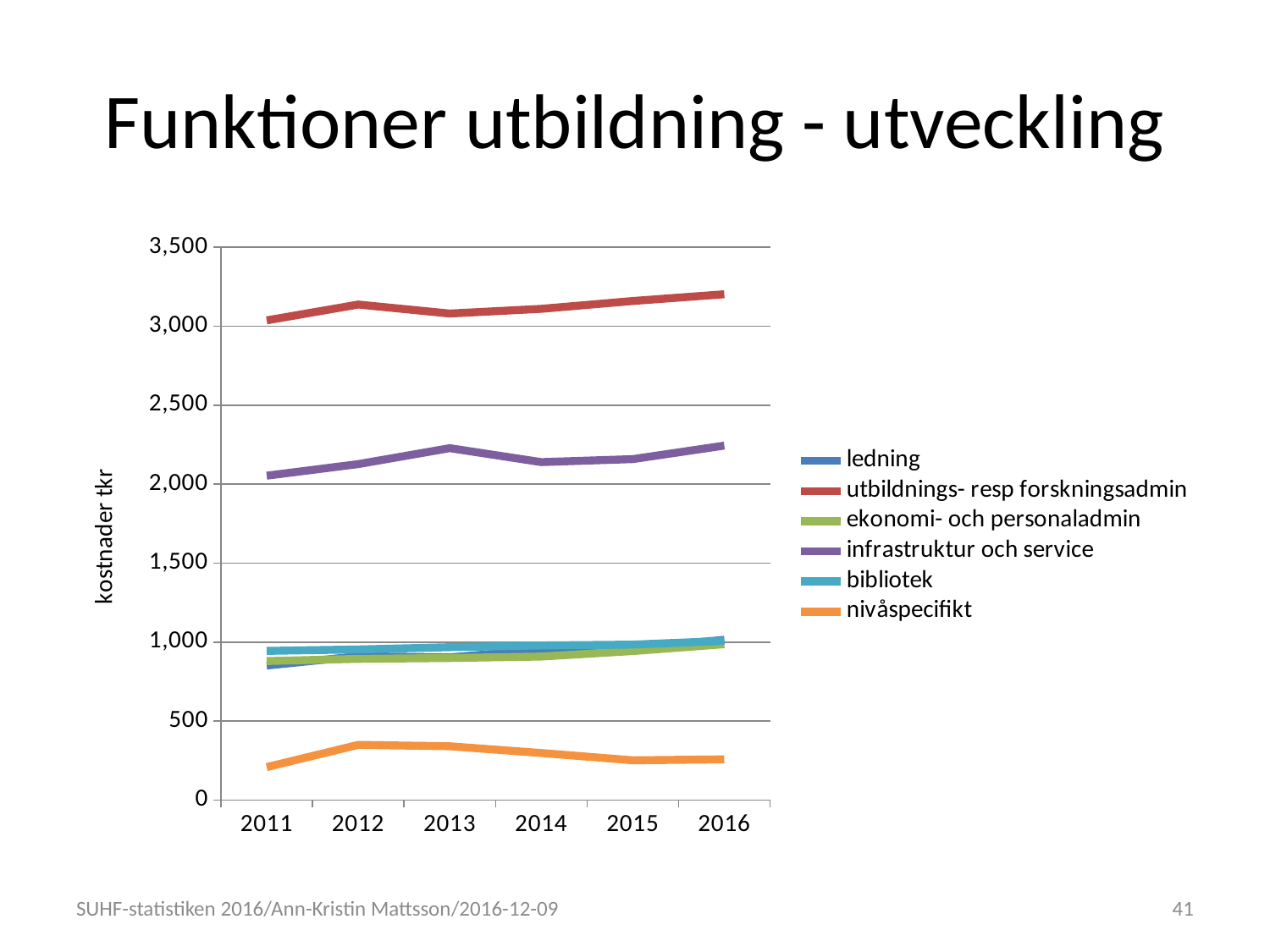
Is the value for infrastruktur och service in 2013 greater or less than 2,000? greater Does the nivåspecifikt series rise or fall from 2012 to 2015? fall Which series has the lowest values across all years? nivåspecifikt Is the value for nivåspecifikt in 2012 greater or less than 500? less What kind of chart is shown on the slide? line chart In 2016, which is larger: infrastruktur och service or bibliotek? infrastruktur och service What is the label on the y axis? kostnader tkr How many years are plotted along the x axis? 6 Is the value for utbildnings- resp forskningsadmin in 2016 greater or less than 3,000? greater How many series does the legend list? 6 Which series has the highest values across all years? utbildnings- resp forskningsadmin